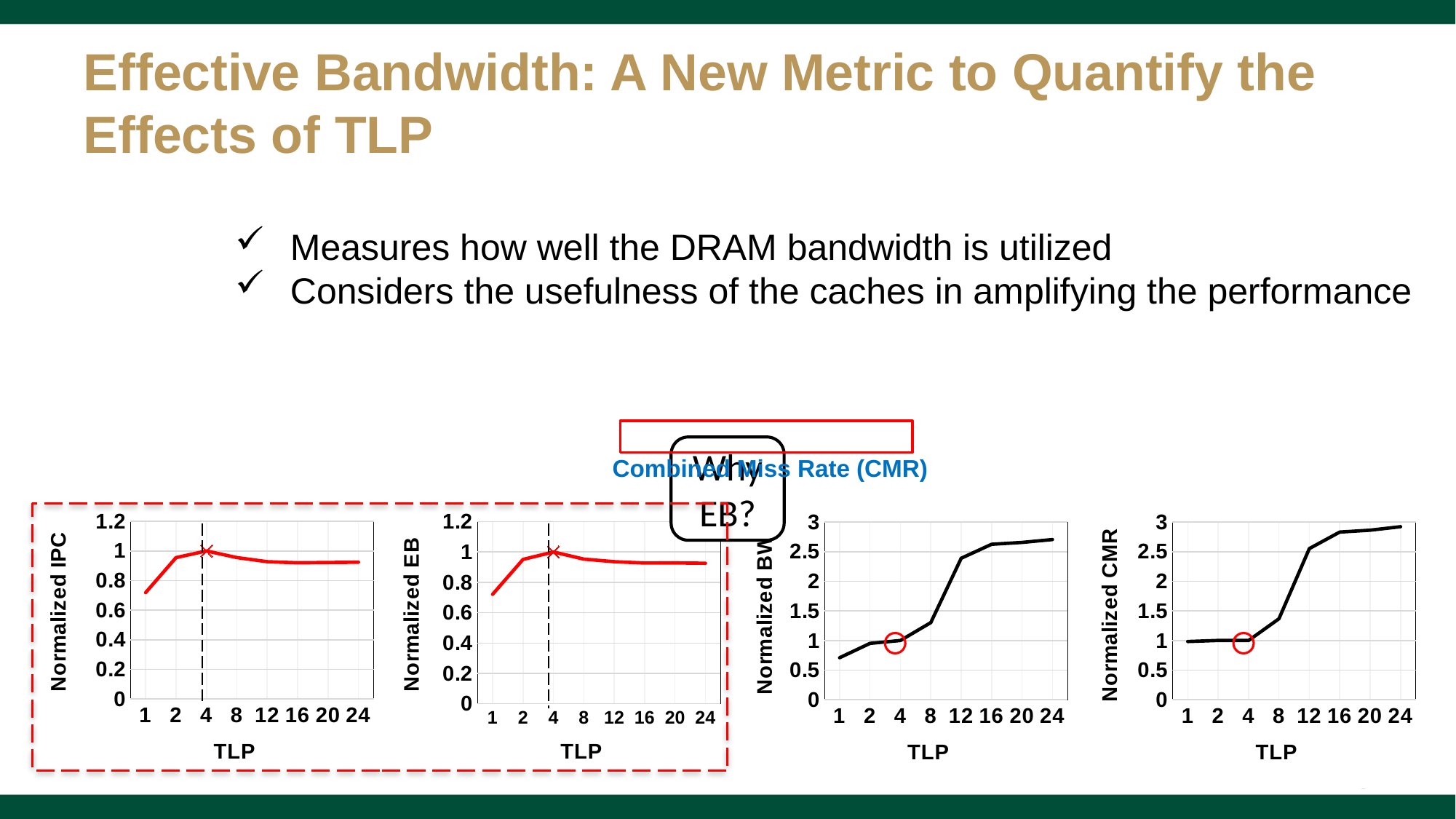
In the Normalized IPC chart, at which TLP value does the line reach its highest point? 4 In the Normalized BW chart, do the values rise or fall as TLP increases from 1 to 24? rise How many TLP values are shown on the x axis of the Normalized EB chart? 8 In the Normalized BW chart, which is larger: the value at TLP 12 or the value at TLP 8? TLP 12 In the Normalized EB chart, is the value at TLP 1 greater or less than 0.8? less In the Normalized CMR chart, which TLP value has the highest normalized CMR? 24 In the Normalized CMR chart, is the value at TLP 8 greater or less than 1.5? less In the Normalized EB chart, what is the value at TLP 4? 1 In the Normalized BW chart, is the value at TLP 24 greater or less than 2.5? greater What type of chart is the Normalized IPC chart? line chart In the Normalized IPC chart, at which TLP value is the line lowest? 1 What is the x-axis label on the Normalized CMR chart? TLP